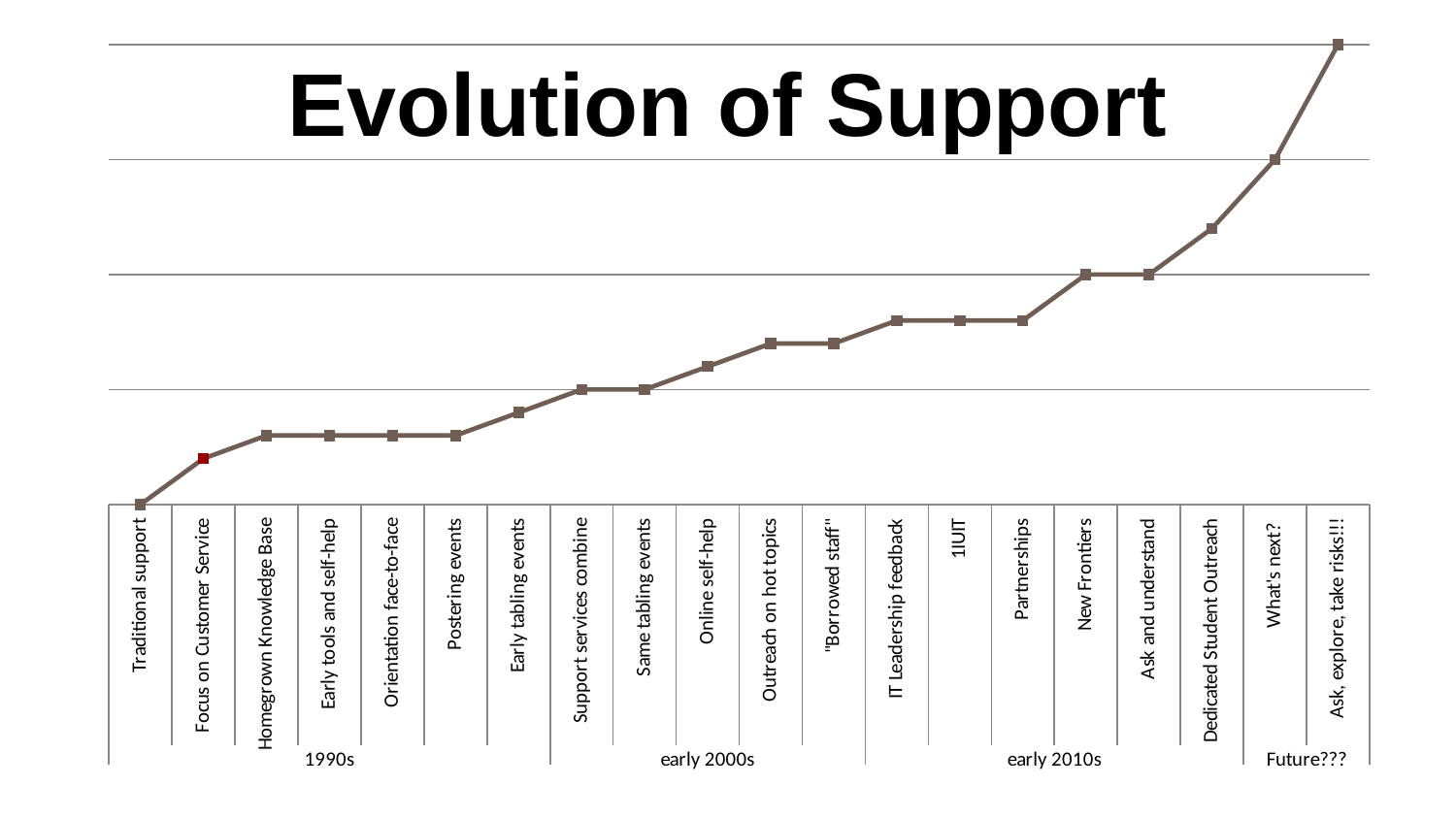
What is the title of the chart? Evolution of Support Which has the larger value, "Traditional support" or "Homegrown Knowledge Base"? Homegrown Knowledge Base Which has the larger value, "Dedicated Student Outreach" or "Ask and understand"? Dedicated Student Outreach Which category's data point is marked in red instead of brown? Focus on Customer Service What kind of chart is shown on the slide? line chart Which has the larger value, "Online self-help" or "Early tabling events"? Online self-help Which category has the highest value? Ask, explore, take risks!!! How many categories are plotted along the x axis? 20 Do the values generally rise or fall from left to right along the x axis? rise Which category has the lowest value? Traditional support